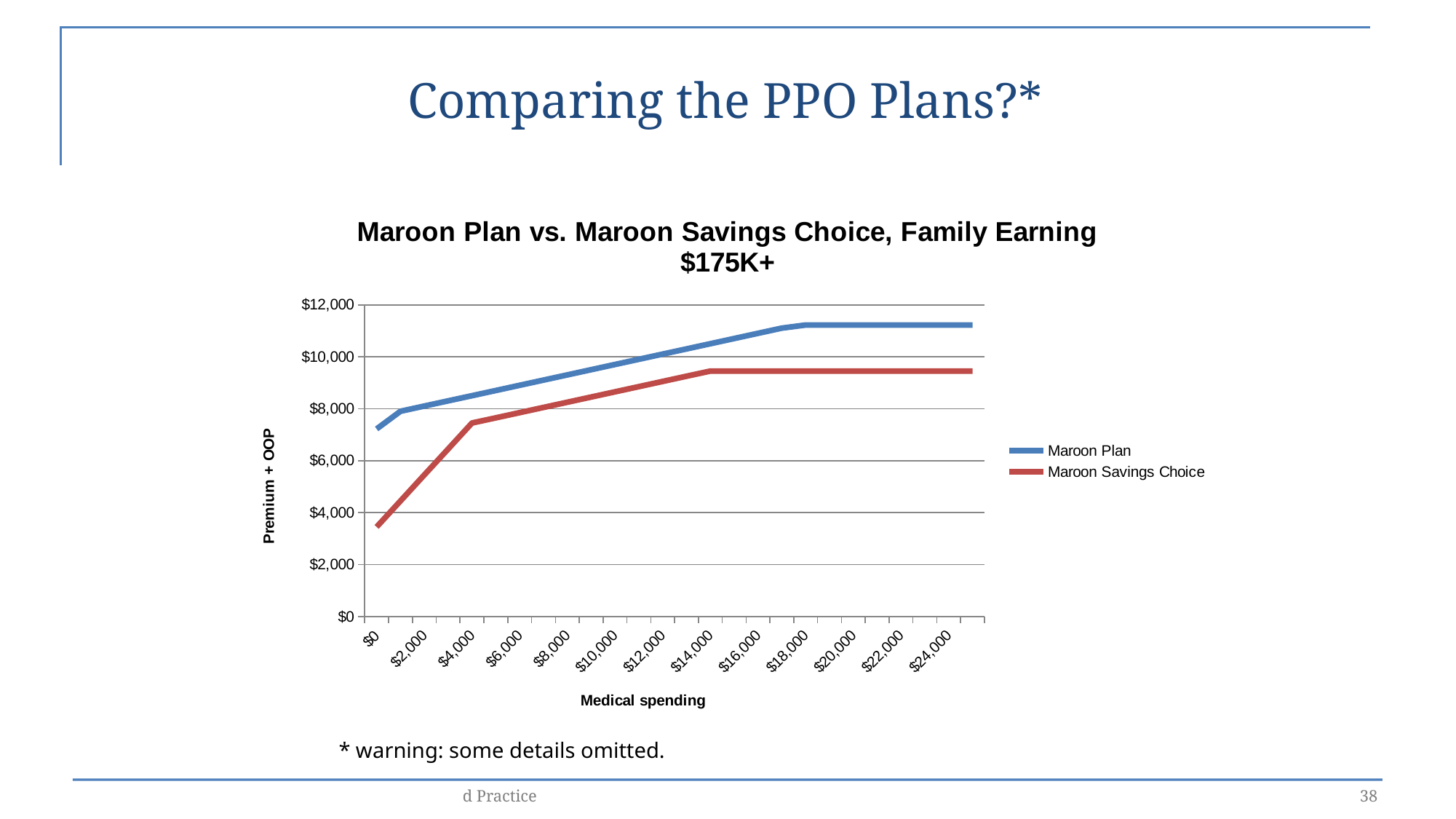
What kind of chart is shown on the slide? Line chart Is the value for Maroon Savings Choice at $4,000 medical spending greater or less than $8,000? less At $0 medical spending, which series has the higher value, Maroon Plan or Maroon Savings Choice? Maroon Plan What is the title of the chart? Maroon Plan vs. Maroon Savings Choice, Family Earning $175K+ Is the value for Maroon Plan at $24,000 medical spending greater or less than $10,000? greater Does the Maroon Savings Choice line rise or fall as medical spending increases from $0 to $14,000? Rise Is the value for Maroon Plan at $0 medical spending greater or less than $6,000? greater What is the label of the vertical axis? Premium + OOP How many series does the legend list? 2 How many labelled tick marks are on the Medical spending axis? 13